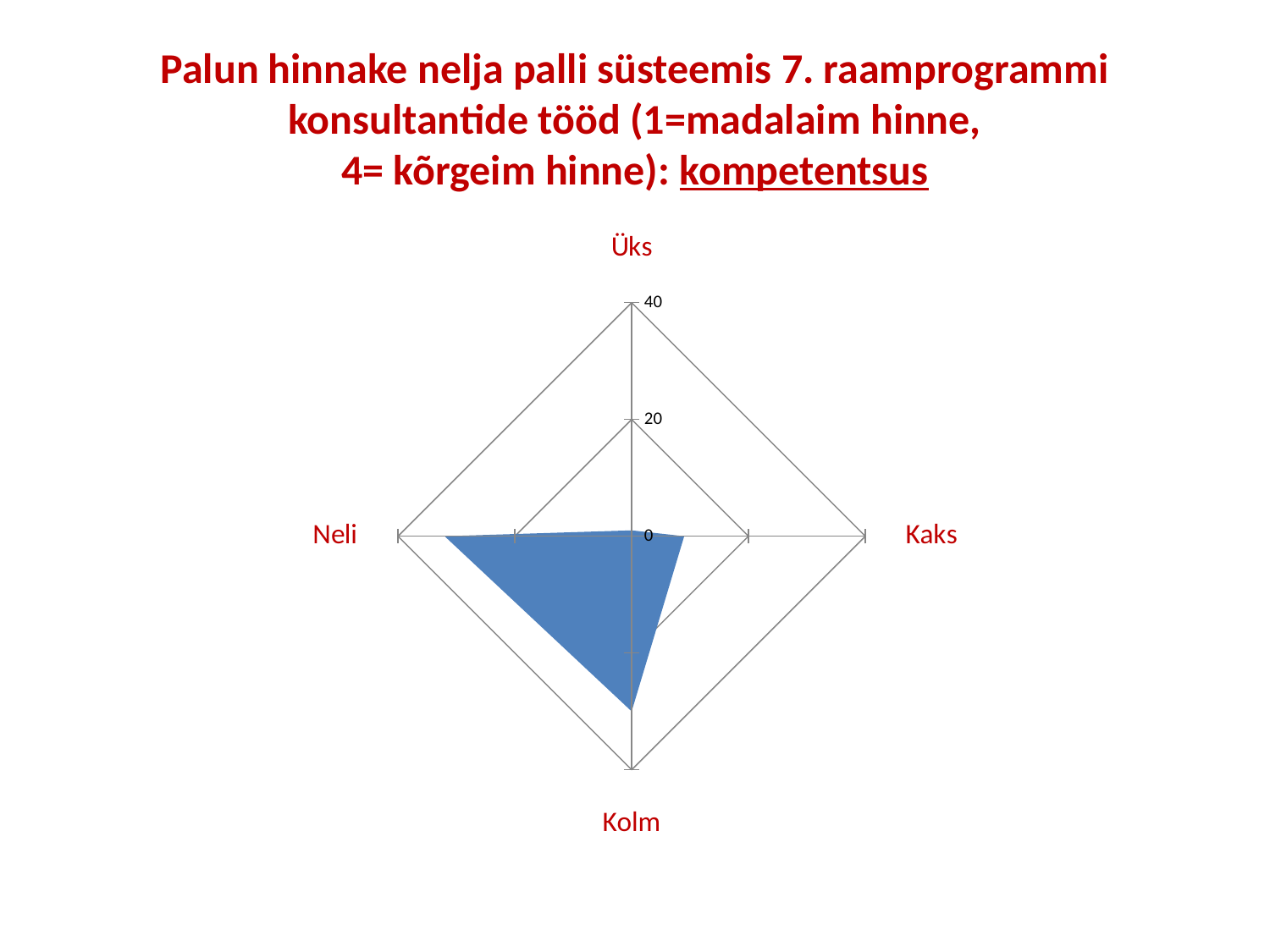
Which is larger, the value for Kolm or the value for Kaks? Kolm Which word is underlined in the slide title? kompetentsus How many categories (axes) does the radar chart have? 4 What kind of chart is shown on the slide? radar chart What is the highest value shown on the radar chart's axis scale? 40 Is the value for Neli greater or less than 20? greater Which category has the lowest value on the radar chart? Üks Is the value for Kaks greater or less than 20? less Is the value for Üks greater or less than 20? less Which is larger, the value for Neli or the value for Üks? Neli